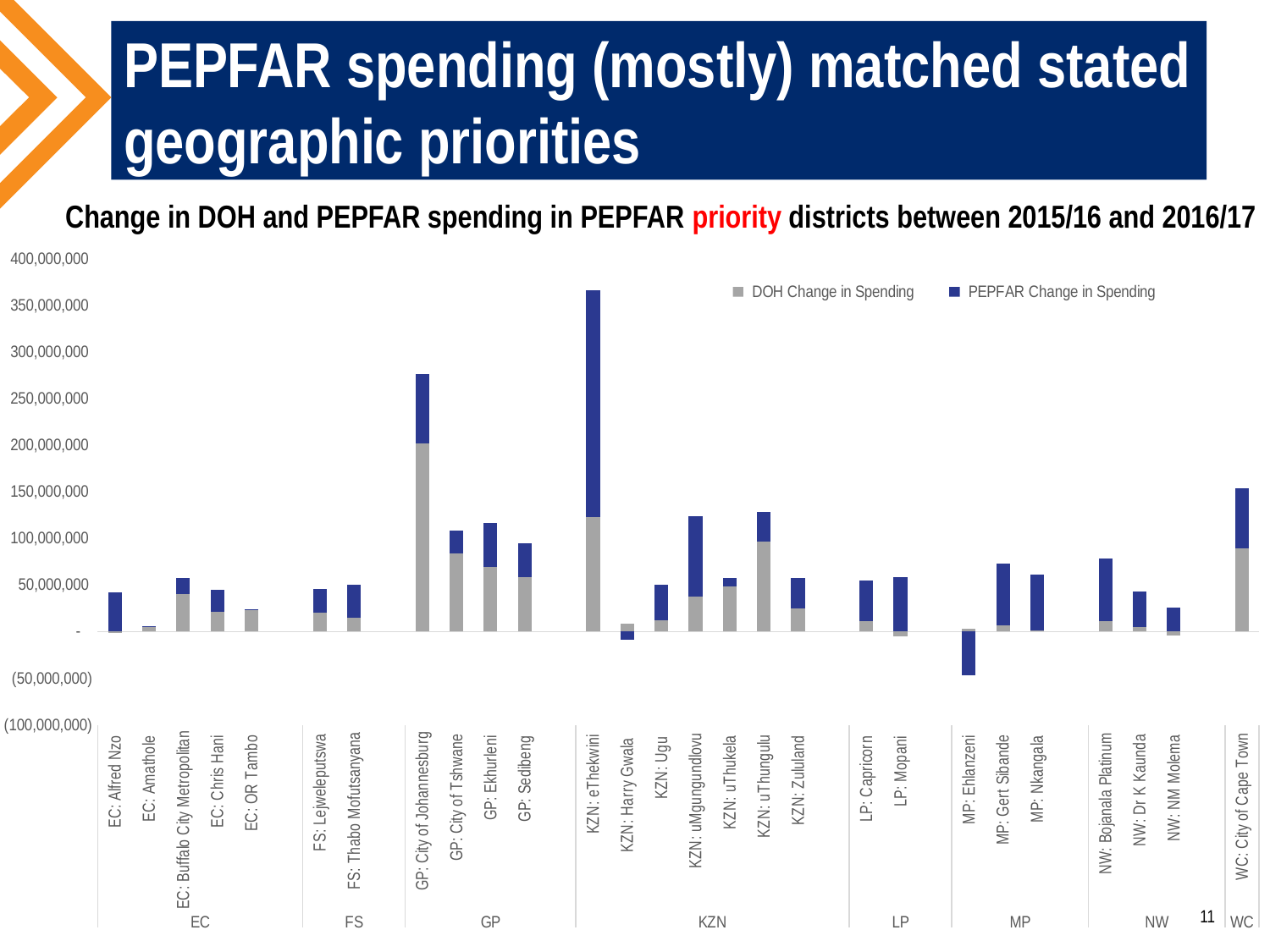
How many province groups are shown along the x axis? 8 Which district has the highest total change in spending? KZN: eThekwini What kind of chart is shown on the slide? Stacked bar chart How many series does the legend list? 2 Is the total change in spending for GP: City of Johannesburg greater or less than 250,000,000? greater Which district has the lowest total change in spending? MP: Ehlanzeni Is the total change in spending for WC: City of Cape Town greater or less than 100,000,000? greater What are the two series named in the legend? DOH Change in Spending and PEPFAR Change in Spending Is the total change in spending for KZN: eThekwini greater or less than 300,000,000? greater How many districts are plotted along the x axis? 27 Which has the larger total change in spending, GP: City of Johannesburg or GP: City of Tshwane? GP: City of Johannesburg Which has the larger DOH Change in Spending, GP: City of Johannesburg or KZN: eThekwini? GP: City of Johannesburg